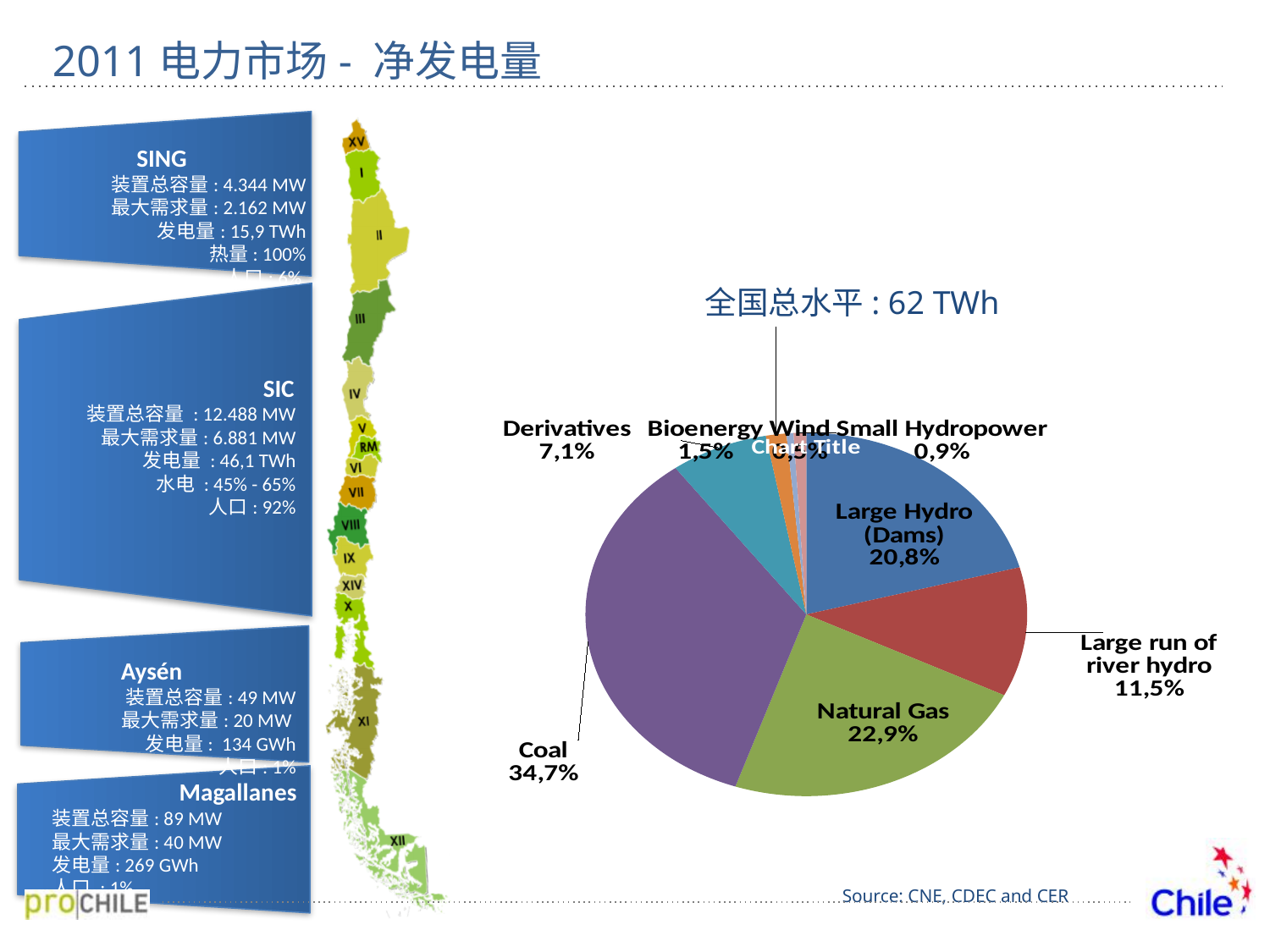
What is the value for Large run of river hydro? 11,5% What share of the pie does Coal account for? 34,7% Which is larger, the share for Natural Gas or the share for Large Hydro (Dams)? Natural Gas What kind of chart is shown on the slide? Pie chart What is the difference between the Coal share and the Natural Gas share? 11,8% How many categories are shown in the pie chart? 8 What is the value shown for Natural Gas in the pie chart? 22,9% What national total is stated above the pie chart? 62 TWh What percentage is shown for Large Hydro (Dams)? 20,8% What is the value shown for Small Hydropower? 0,9% Which category has the largest share of the pie? Coal What percentage is shown for Derivatives? 7,1%